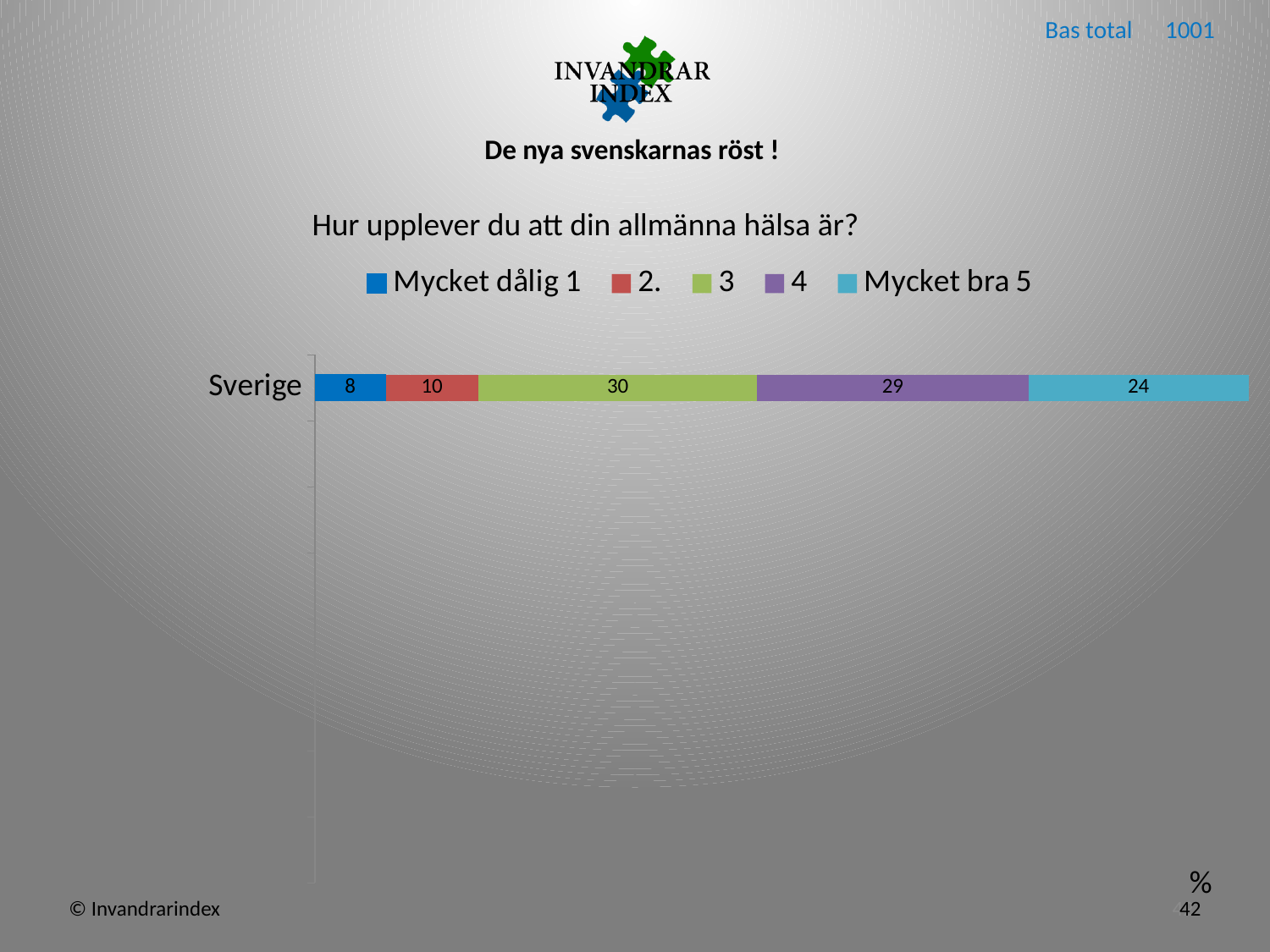
How many series does the legend list? 5 Which series has the lowest value for Sverige? Mycket dålig 1 What is the value for "3" for Sverige? 30 Which series has the highest value for Sverige? 3 What is the difference between the values for "4" and "2." for Sverige? 19 Which is larger for Sverige, the value for "Mycket bra 5" or the value for "2."? Mycket bra 5 What is the value for "4" for Sverige? 29 What is the title of the chart? Hur upplever du att din allmänna hälsa är? What is the value for "Mycket dålig 1" for Sverige? 8 What kind of chart is shown on the slide? Stacked bar chart What is the total of the stacked bar for Sverige? 101 What is the value for "Mycket bra 5" for Sverige? 24